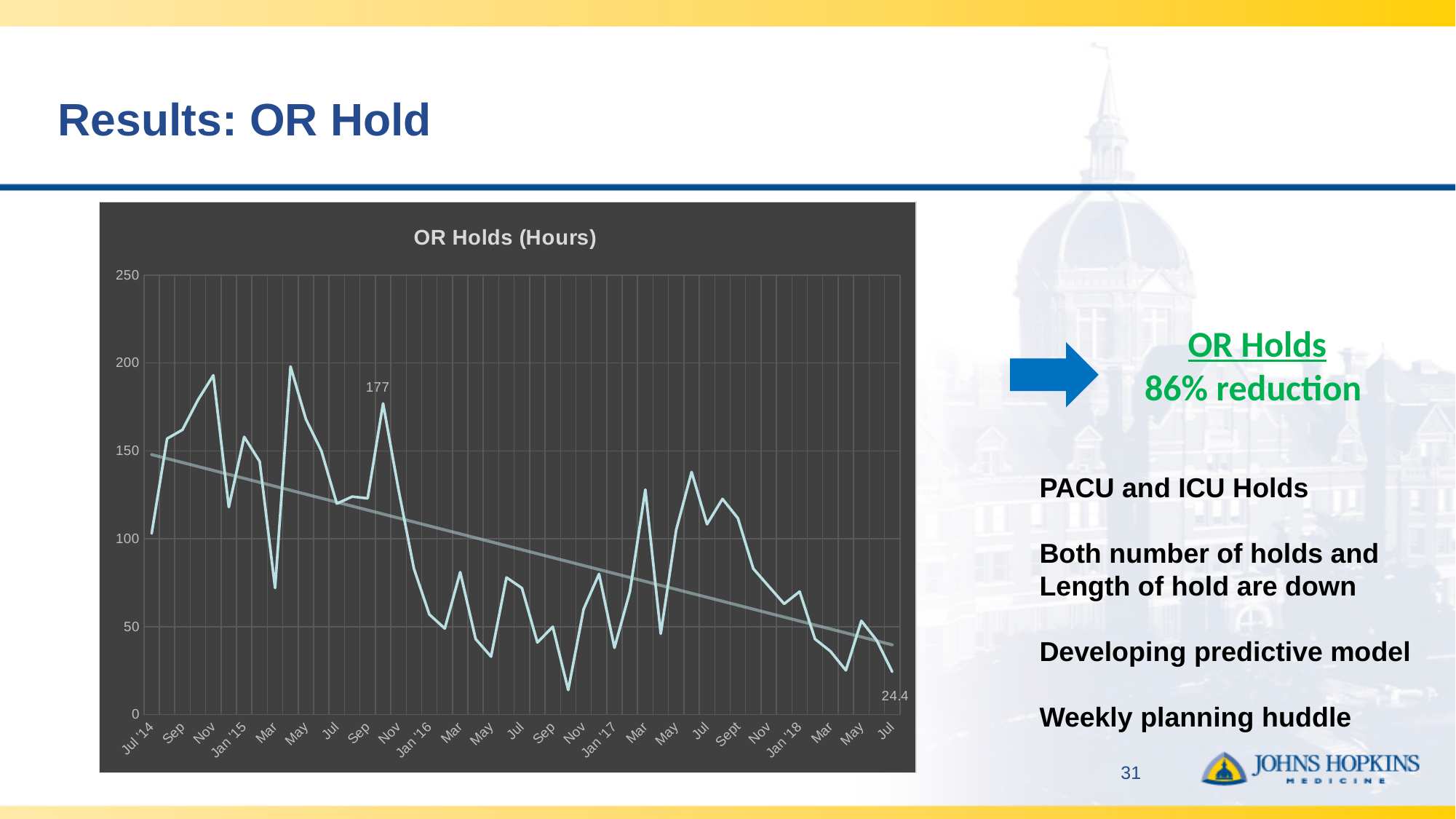
Is the value for Jul '17 greater or less than 100? greater Is the value for Mar '15 greater or less than 100? less What is the highest data-labeled value on the OR Holds (Hours) chart? 177 What is the maximum value shown on the y axis of the chart? 250 What is the title of the chart? OR Holds (Hours) What kind of chart is shown on the slide? line chart Which is larger, the value for Nov '14 or the value for Jul '18? Nov '14 Is the value for Jan '17 greater or less than 100? less Overall, do OR hold hours rise or fall from Jul '14 to Jul '18? fall What is the difference between the labeled peak value of 177 and the final labeled value of 24.4? 152.6 What is the value labeled at the last point (Jul '18) on the OR Holds (Hours) chart? 24.4